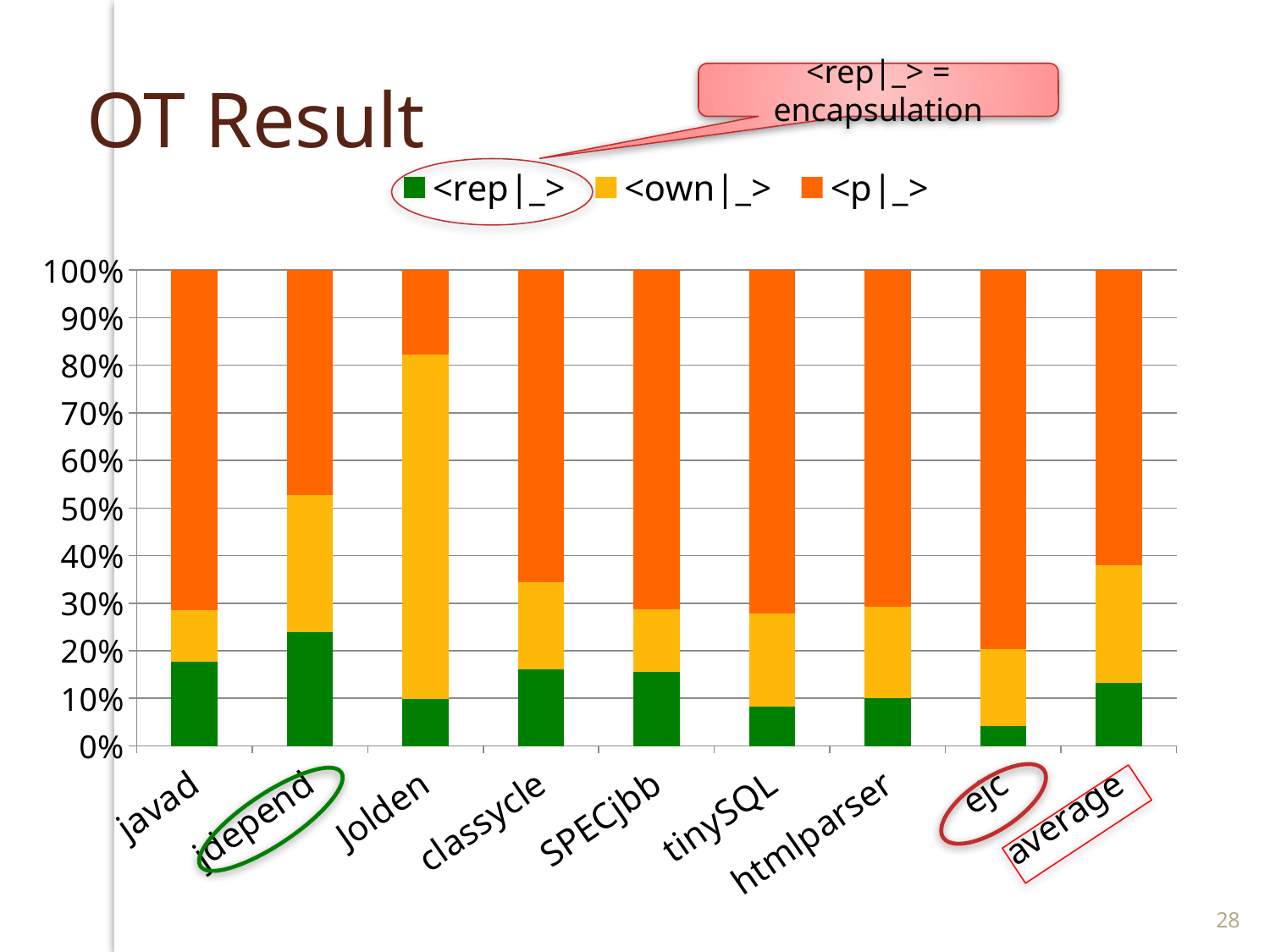
What is the title of the slide containing the chart? OT Result Which category has the largest <p|_> segment? ejc Which category has the smallest <rep|_> segment? ejc Is the <own|_> segment for Jolden greater or less than 50%? greater How many categories are shown along the x axis of the chart? 9 Is the <rep|_> value for jdepend greater or less than 20%? greater How many series does the chart legend list? 3 Which category has the largest <rep|_> segment? jdepend What kind of chart is shown on the slide? stacked bar chart Which has a larger <rep|_> segment, jdepend or Jolden? jdepend Which category has the largest <own|_> segment? Jolden Is the <rep|_> value for ejc greater or less than 10%? less